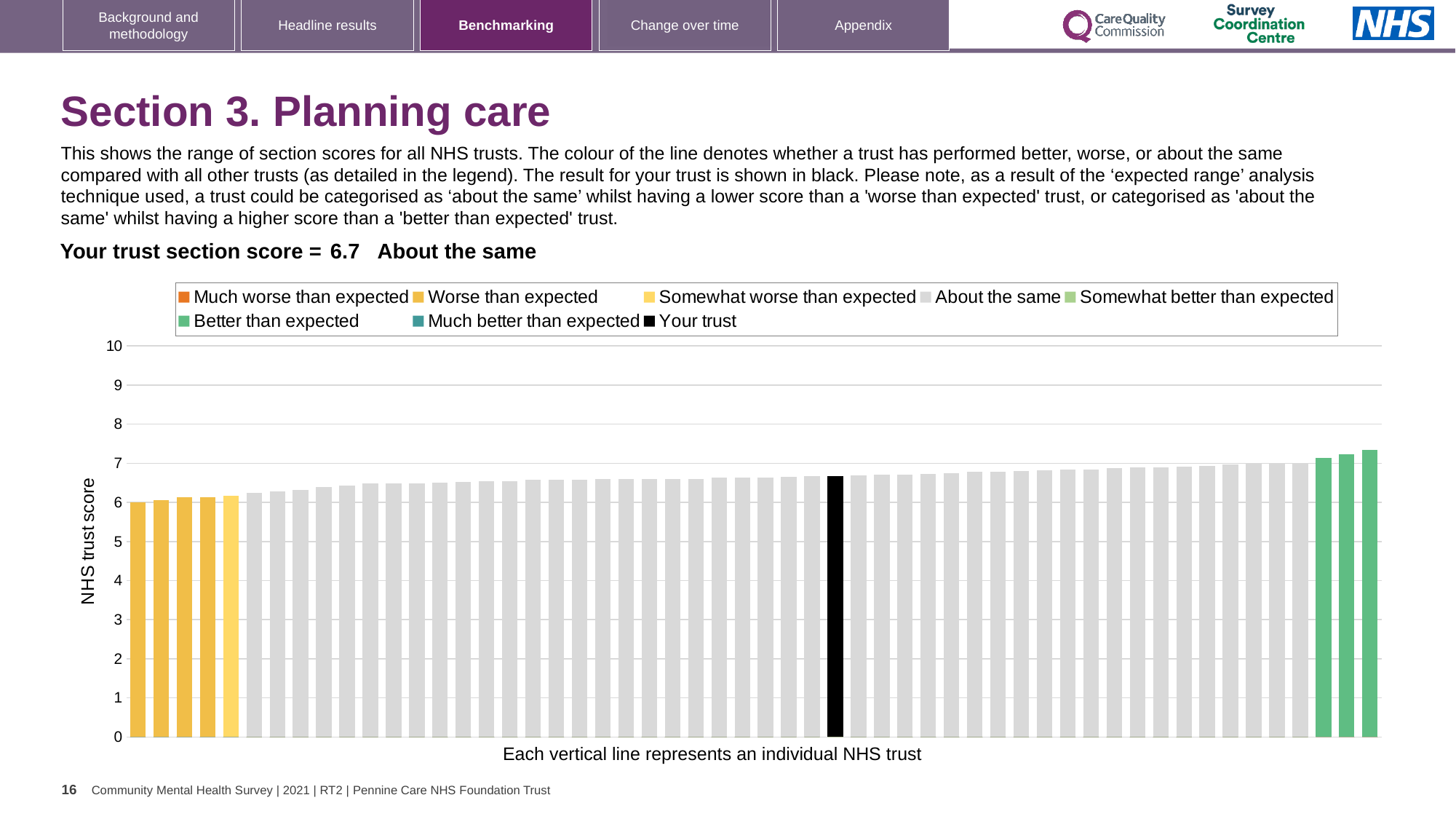
Is the value of the black 'Your trust' bar greater or less than 7? less What kind of chart is shown on the slide? bar chart Is the value of the rightmost (highest) bar greater or less than 7? greater What is the trust's section score shown on the slide? 6.7 How many entries does the chart legend list? 8 Is the value of the leftmost (lowest) bar greater or less than 5? greater Which category is the trust's section score placed in, according to the text above the chart? About the same What colour is used for the 'Your trust' bar in the chart? black What is the label on the vertical axis of the chart? NHS trust score Do the bar values rise or fall from left to right along the x axis? rise How many bars are coloured green ('Better than expected')? 3